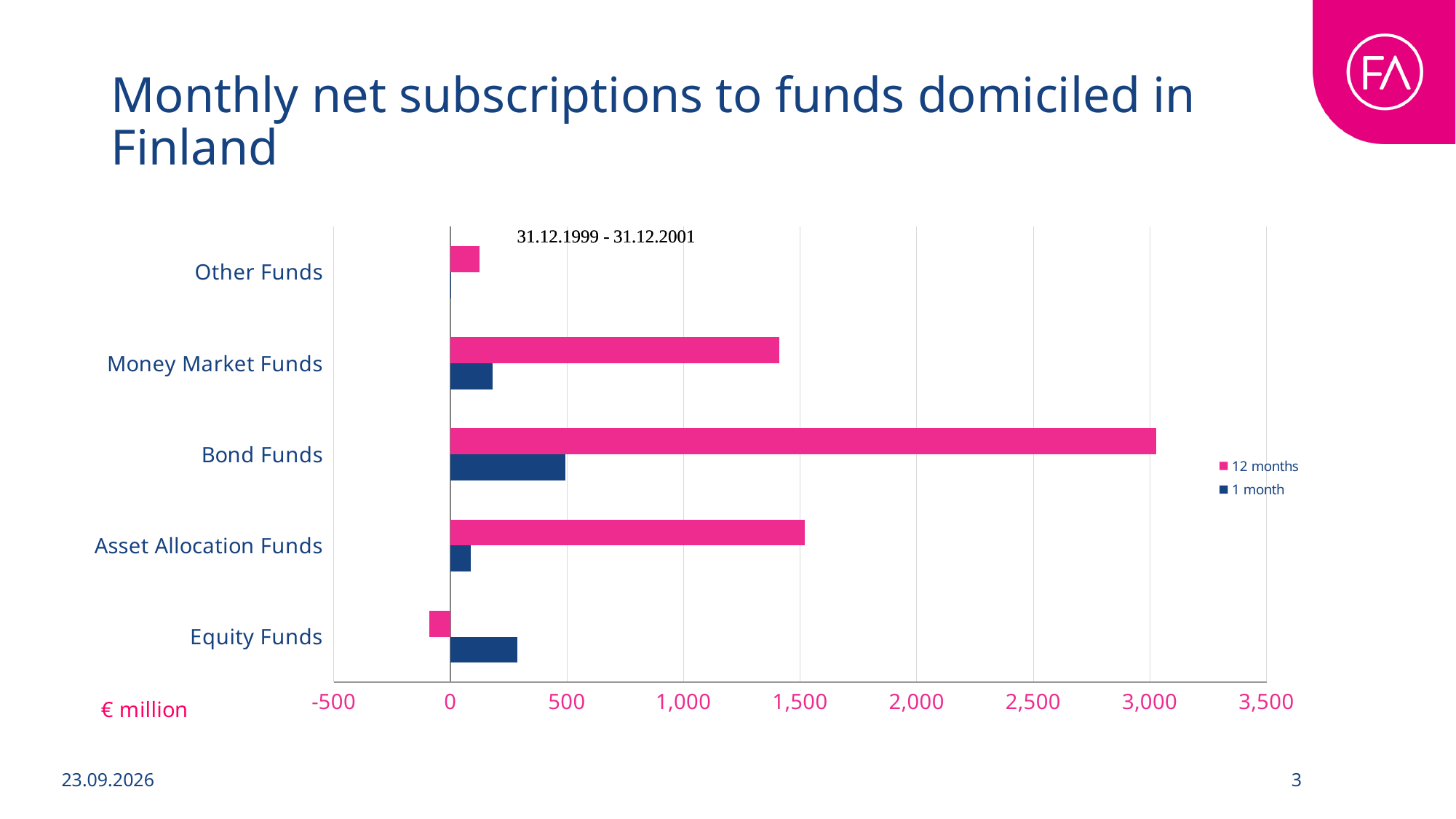
How many fund categories are shown on the chart? 5 What unit is shown for the x axis of the chart? € million Which fund category has the highest 1 month value? Bond Funds Is the 12 months value for Bond Funds greater or less than 2,500? greater Which fund category has the highest 12 months value? Bond Funds What kind of chart is shown on the slide? Bar chart Which fund category has the lowest 12 months value? Equity Funds Which is larger: the 1 month value for Equity Funds or the 1 month value for Money Market Funds? Equity Funds How many series does the legend list? 2 Is the 12 months value for Equity Funds greater or less than 0? less Is the 12 months value for Money Market Funds greater or less than 1,500? less Which colour represents the 12 months series in the legend? Pink